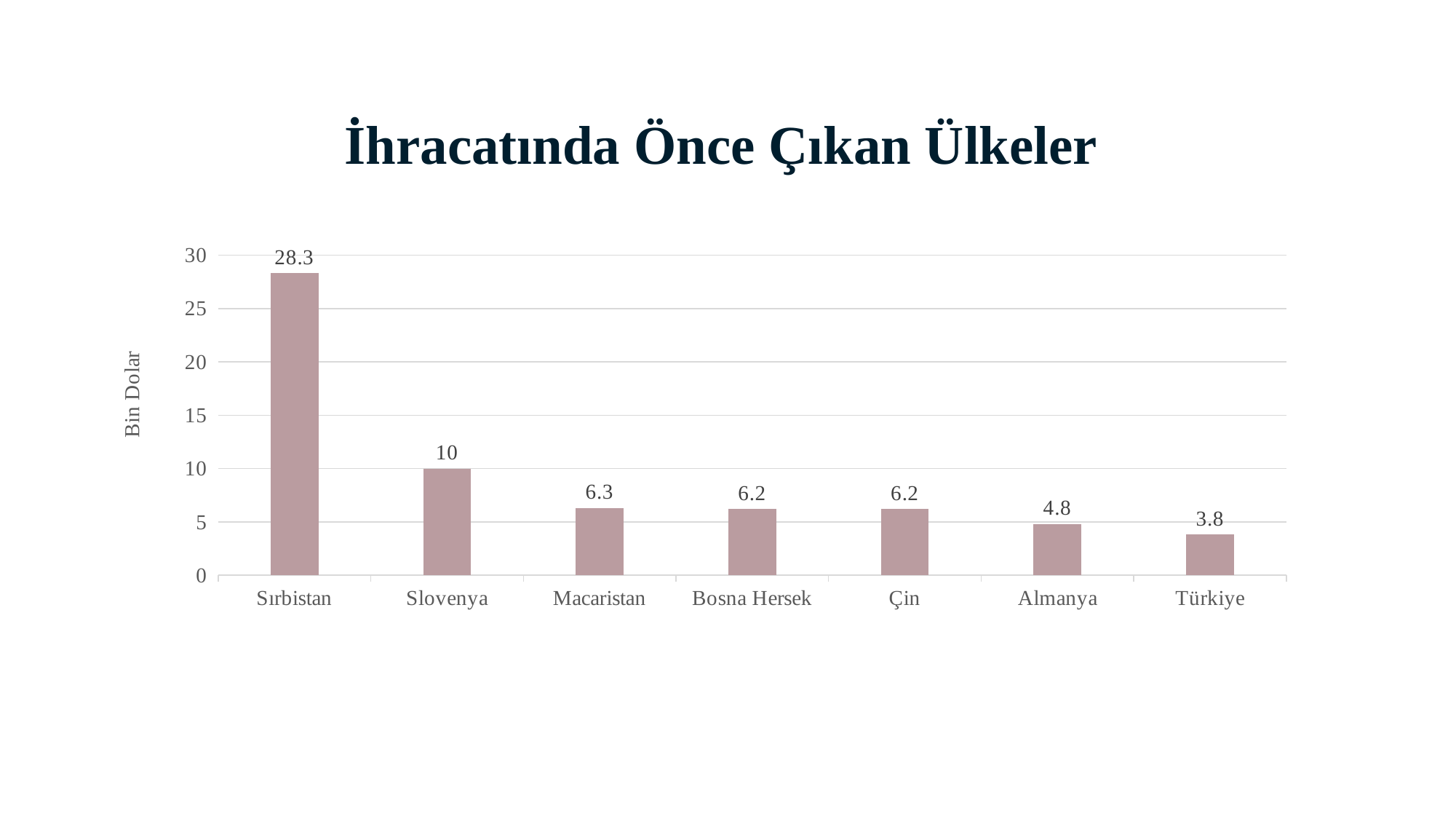
What is the value for Sırbistan? 28.3 What is the difference between the values for Macaristan and Türkiye? 2.5 What kind of chart is shown on the slide? Bar chart What is the value for Almanya? 4.8 What is the label on the vertical axis? Bin Dolar How many countries are shown on the chart? 7 Which country has the highest value? Sırbistan Which country has the lowest value? Türkiye What is the difference between the values for Sırbistan and Slovenya? 18.3 What is the value for Slovenya? 10 What is the value for Türkiye? 3.8 Which is larger, the value for Slovenya or the value for Almanya? Slovenya